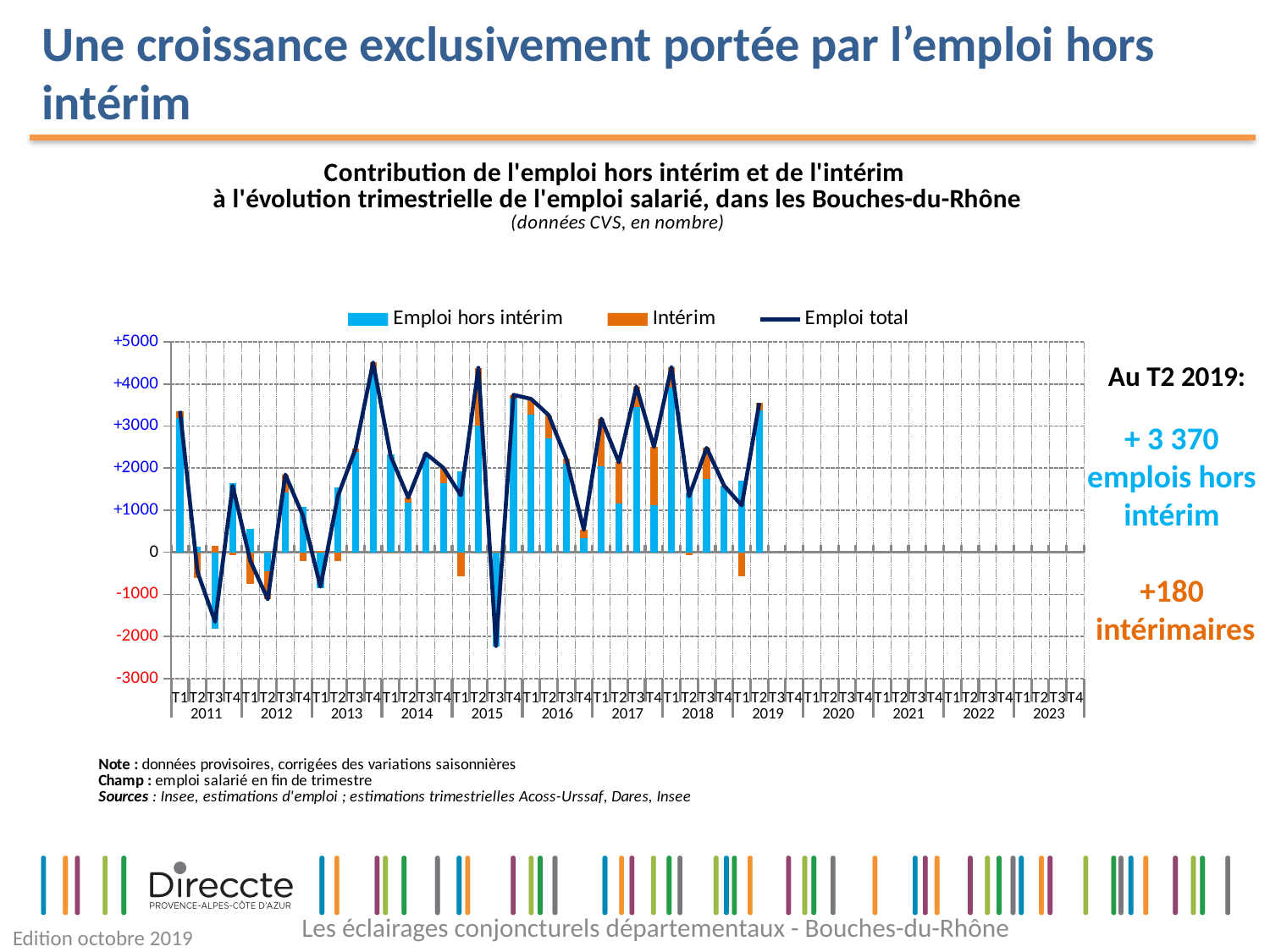
At T2 2019, which is larger: Emploi hors intérim or Intérim? Emploi hors intérim Is the lowest value of the Emploi total line greater or less than -2000? less Does the Emploi total line rise or fall from T1 2019 to T2 2019? rise How many years are labelled on the x axis? 13 According to the slide, what is the value for Intérim at T2 2019? +180 Which colour represents the Intérim series? Orange In which year does the Emploi total line reach its lowest value? 2015 Is the value of the Emploi total line at T4 2013 greater or less than 4000? greater According to the slide, what is the value for Emploi hors intérim at T2 2019? + 3 370 What kind of chart is this? A combined bar and line chart (stacked bars with a line) What is the total of the stacked bar at T2 2019 (Emploi hors intérim plus Intérim)? 3 550 How many series does the chart legend list? 3